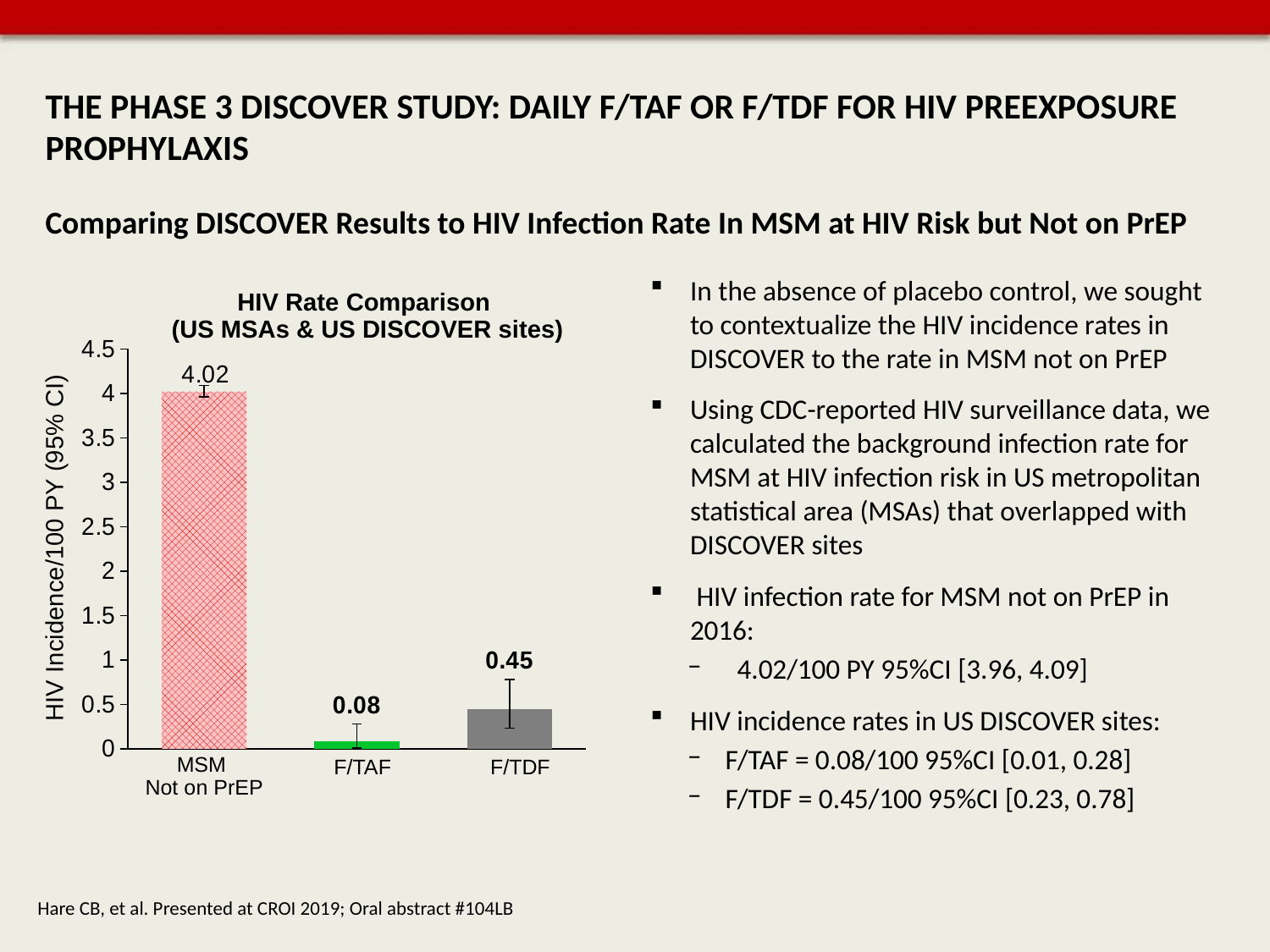
What kind of chart is shown? bar chart What is the difference in HIV incidence between MSM Not on PrEP and F/TDF? 3.57 Is the value for MSM Not on PrEP greater or less than 4? greater Which category has the lowest HIV incidence? F/TAF How many categories are shown on the x axis? 3 Which category has the highest HIV incidence? MSM Not on PrEP What is the title of the chart? HIV Rate Comparison (US MSAs & US DISCOVER sites) What is the HIV incidence per 100 PY for F/TDF? 0.45 What is the HIV incidence per 100 PY for F/TAF? 0.08 What is the HIV incidence per 100 PY for MSM Not on PrEP? 4.02 What is the difference in HIV incidence between F/TDF and F/TAF? 0.37 Which has a higher HIV incidence, F/TAF or F/TDF? F/TDF